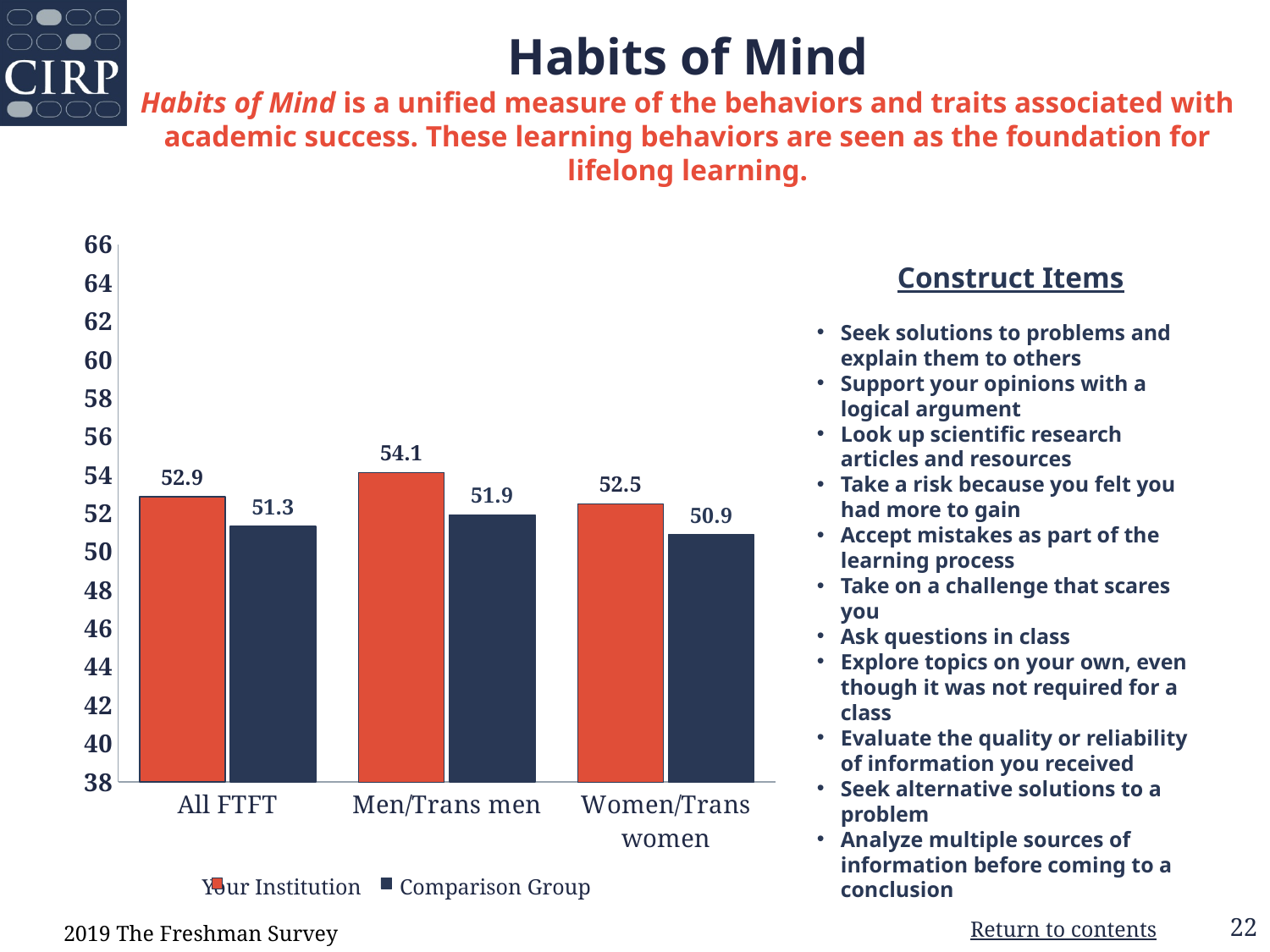
What is the title of the slide's chart section? Habits of Mind What kind of chart is shown on the slide? Bar chart Which category has the highest Your Institution value? Men/Trans men What is the Comparison Group value for Women/Trans women? 50.9 How many categories are shown on the x axis? 3 What is the Your Institution value for All FTFT? 52.9 What is the difference between the Your Institution and Comparison Group values for Men/Trans men? 2.2 Which category has the lowest Comparison Group value? Women/Trans women Which is larger for Women/Trans women: Your Institution or Comparison Group? Your Institution What is the difference between the Your Institution and Comparison Group values for All FTFT? 1.6 How many series does the legend list? 2 What is the Your Institution value for Men/Trans men? 54.1